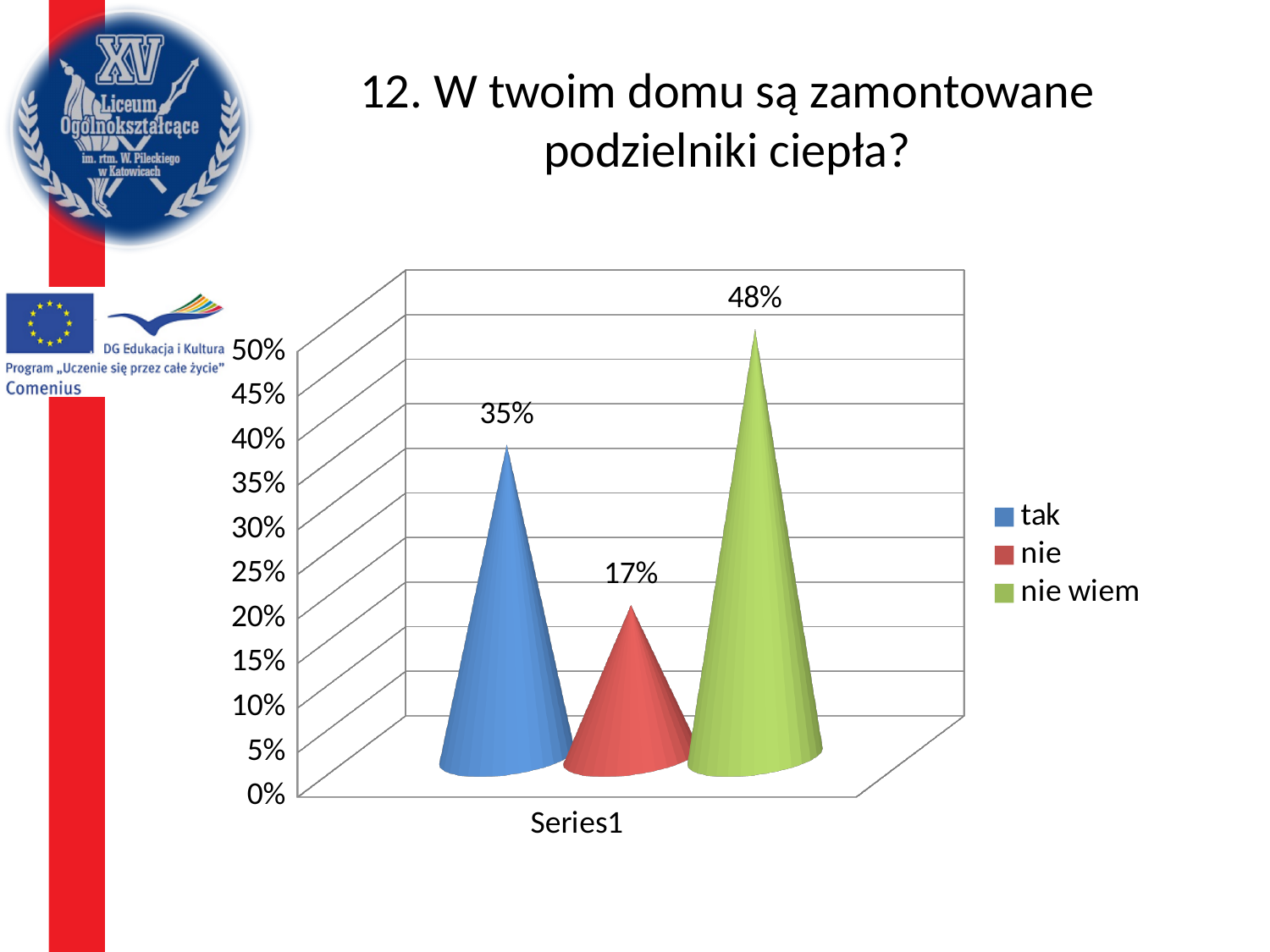
What is the value for "nie"? 17% How many categories does the legend list? 3 What is the value for "nie wiem"? 48% What kind of chart is shown on the slide? bar chart What is the difference between the values for "tak" and "nie"? 18% What is the difference between the values for "nie wiem" and "tak"? 13% Which category has the highest value? nie wiem Is the value for "nie wiem" greater or less than 40%? greater What colour represents "nie wiem" in the legend? green Which is larger, the value for "tak" or the value for "nie"? tak Which category has the lowest value? nie What is the value for "tak"? 35%